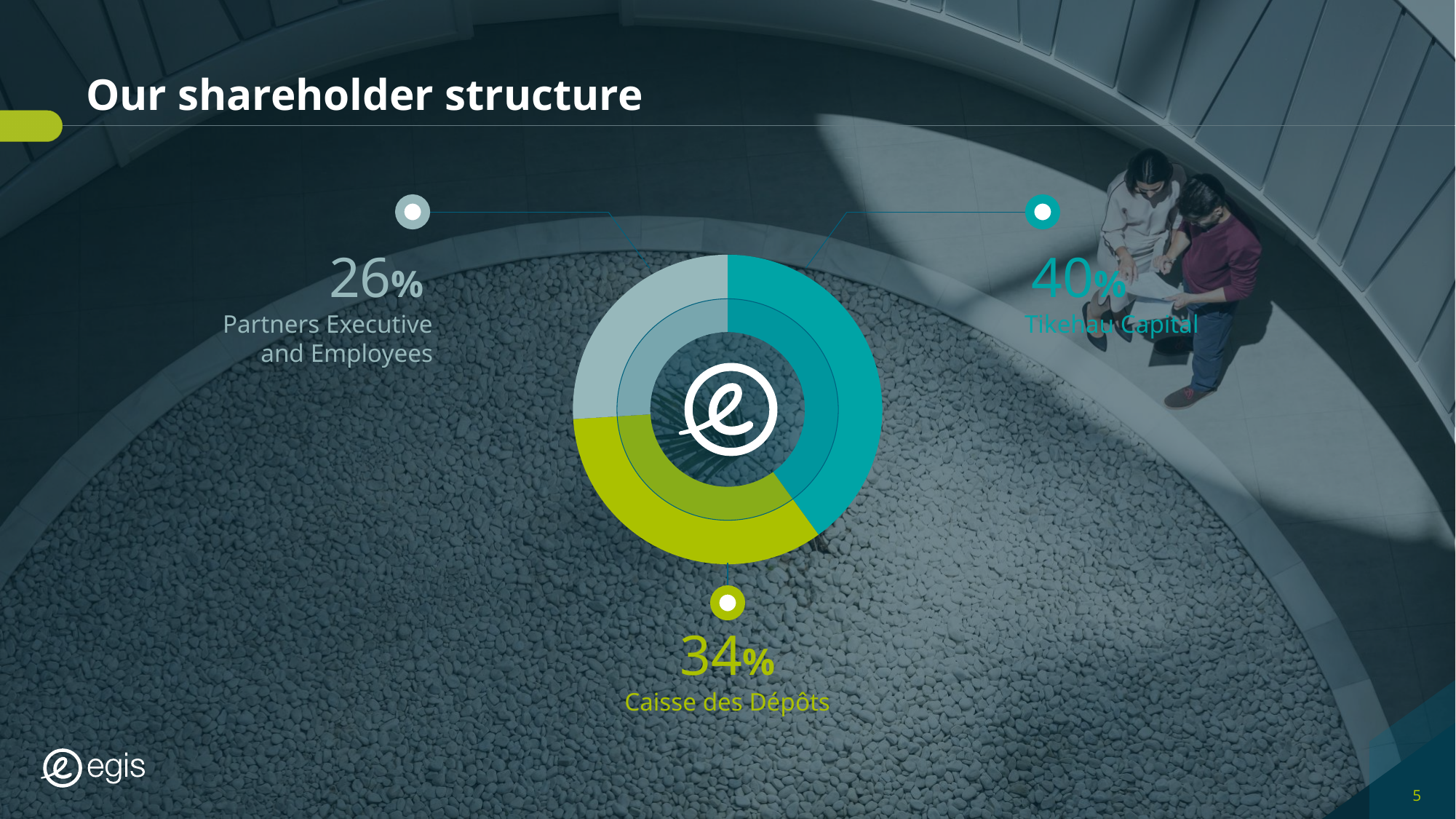
What kind of chart is used to show the shareholder structure? Donut (pie) chart Which is larger: the share held by Caisse des Dépôts or the share held by Partners Executive and Employees? Caisse des Dépôts Which shareholder holds the smallest share? Partners Executive and Employees What share of the shareholder structure is held by Tikehau Capital? 40% What is the title of the slide containing the chart? Our shareholder structure How many shareholder categories are shown in the chart? 3 What share of the shareholder structure is held by Caisse des Dépôts? 34% What colour is the Caisse des Dépôts segment of the chart? Green (lime) What share of the shareholder structure is held by Partners Executive and Employees? 26% Which shareholder holds the largest share? Tikehau Capital What is the difference in percentage points between the Caisse des Dépôts share and the Partners Executive and Employees share? 8 What is the difference in percentage points between the Tikehau Capital share and the Caisse des Dépôts share? 6